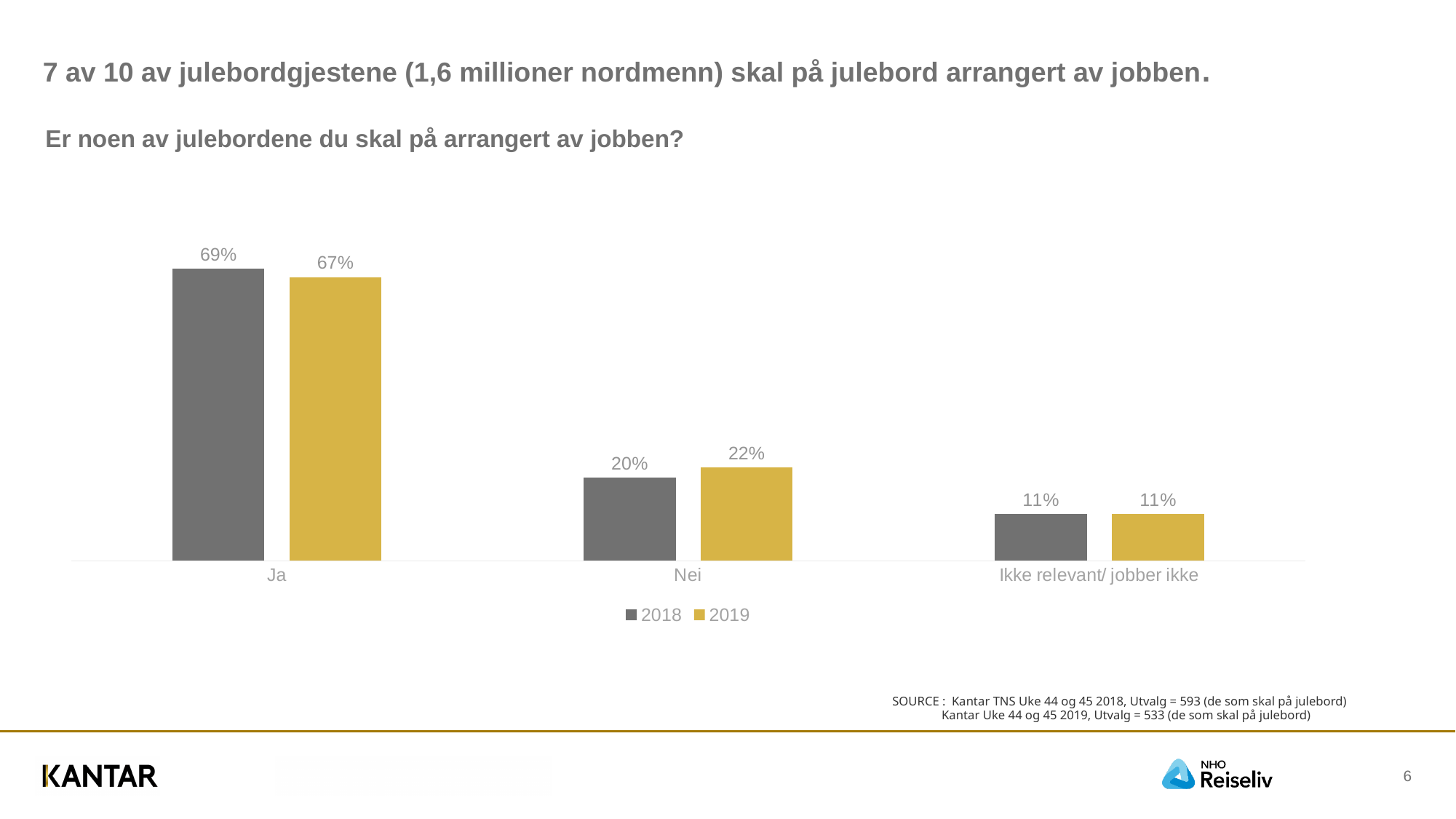
What is the value for "Ikke relevant/ jobber ikke" in the 2018 series? 11% How many series does the legend list? 2 How many categories are shown on the x axis? 3 What is the value for "Ja" in the 2018 series? 69% For "Nei", which series has the larger value, 2018 or 2019? 2019 Which category has the lowest value in the 2019 series? Ikke relevant/ jobber ikke What is the value for "Nei" in the 2019 series? 22% What kind of chart is shown on the slide? Bar chart What is the difference between the 2019 and 2018 values for "Nei"? 2 percentage points Which category has the highest value in the 2018 series? Ja What is the difference between the 2018 and 2019 values for "Ja"? 2 percentage points What is the value for "Ja" in the 2019 series? 67%